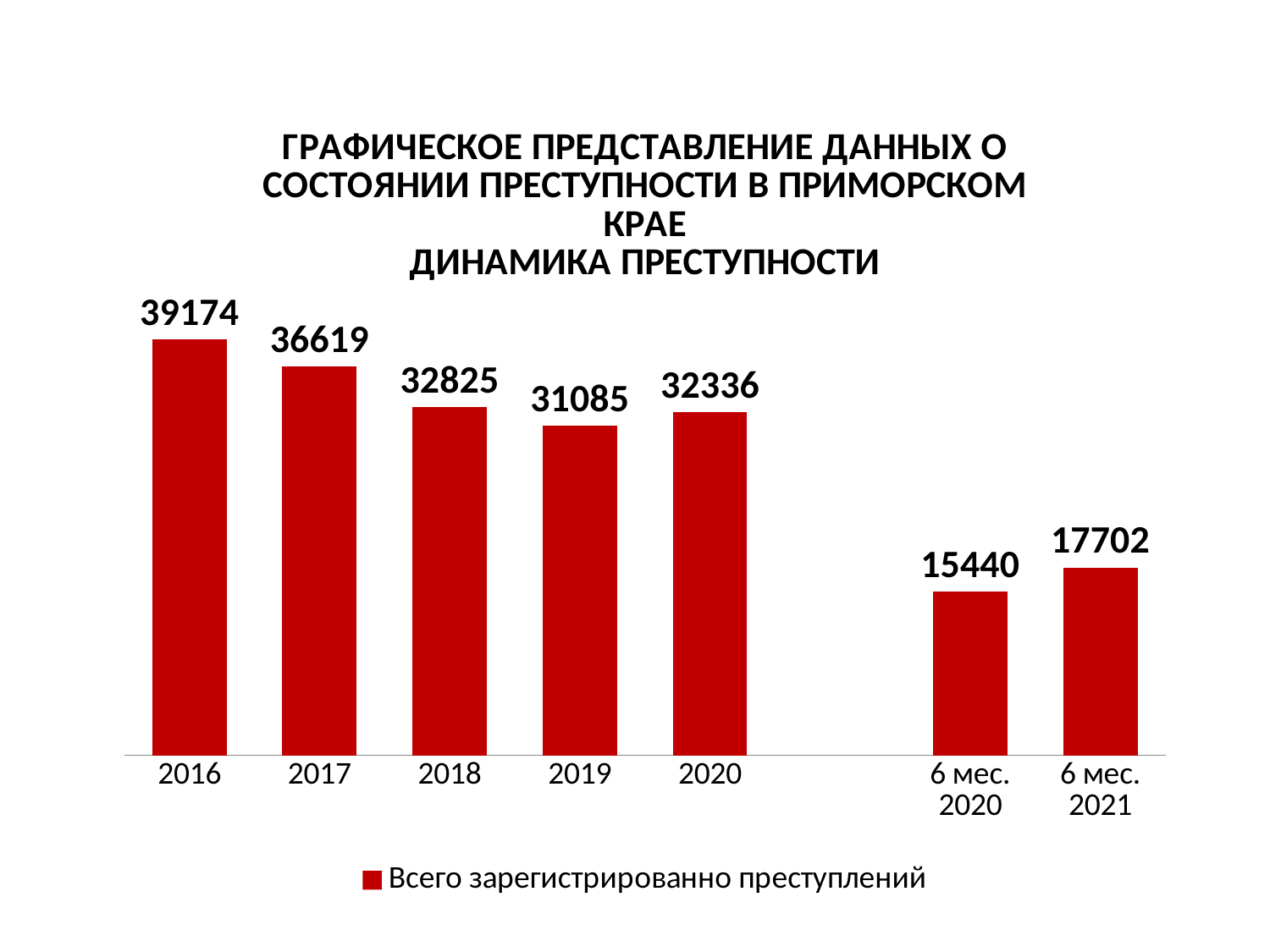
What is the value for 2019? 31085 Which category has the highest value? 2016 What is the difference between the values for 6 мес. 2021 and 6 мес. 2020? 2262 What is the value for 6 мес. 2021? 17702 What is the value for 2016? 39174 Which is larger, the value for 2019 or the value for 2020? 2020 What is the legend entry for the series? Всего зарегистрированно преступлений How many series does the legend list? 1 How many categories are shown on the x axis? 7 Which category has the lowest value? 6 мес. 2020 What kind of chart is this? bar chart What is the difference between the values for 2016 and 2017? 2555